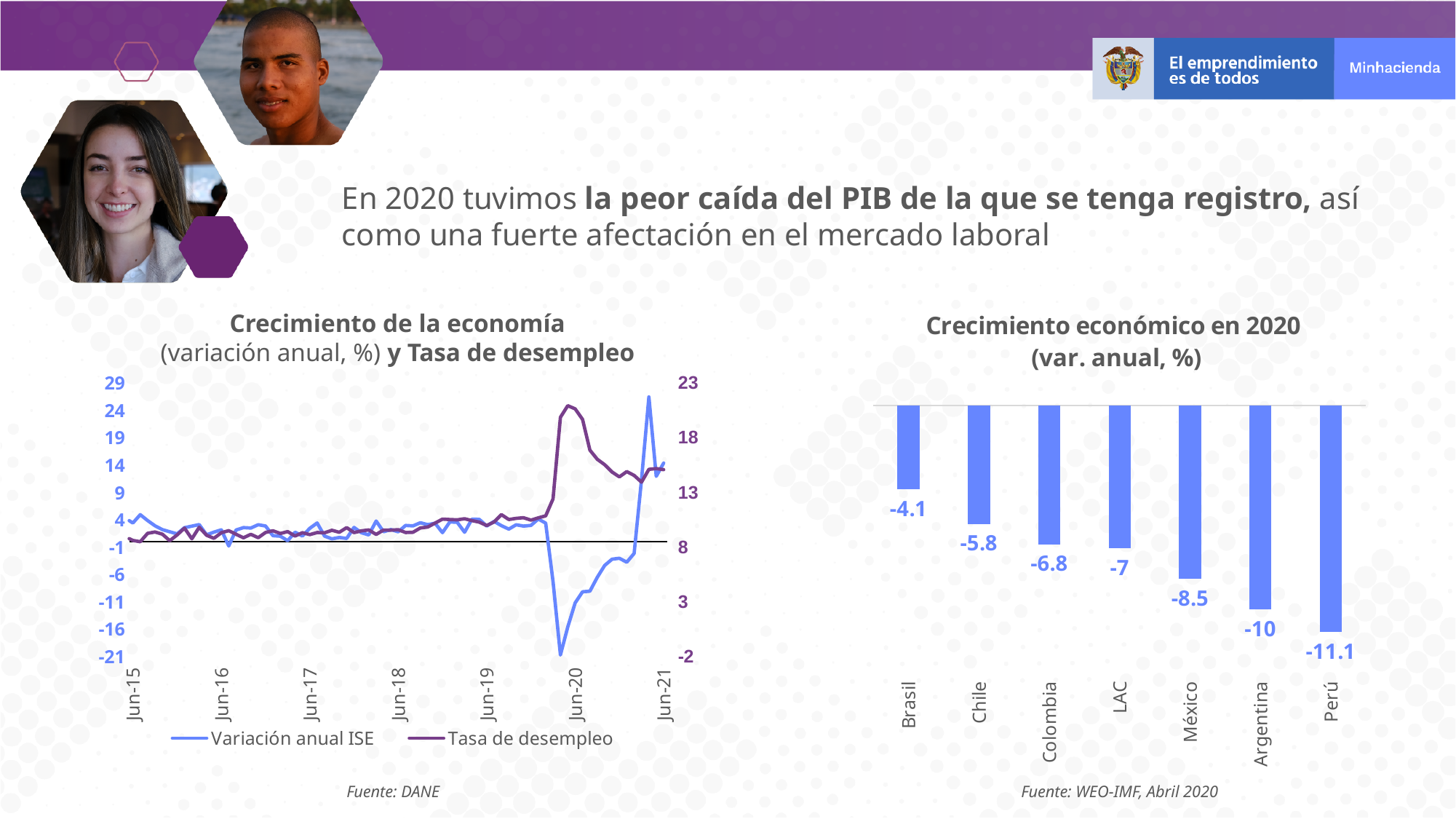
In the chart 'Crecimiento de la economía (variación anual, %) y Tasa de desempleo', which series is drawn in dark purple? Tasa de desempleo In the chart 'Crecimiento económico en 2020 (var. anual, %)', what is the value for LAC? -7 What type of chart is 'Crecimiento de la economía (variación anual, %) y Tasa de desempleo'? Line chart In the chart 'Crecimiento económico en 2020 (var. anual, %)', what is the value for Perú? -11.1 How many countries or regions are shown in the chart 'Crecimiento económico en 2020 (var. anual, %)'? 7 In the chart 'Crecimiento económico en 2020 (var. anual, %)', which country has the lowest value? Perú How many series does the legend of the chart 'Crecimiento de la economía (variación anual, %) y Tasa de desempleo' list? 2 In the chart 'Crecimiento económico en 2020 (var. anual, %)', what is the difference between the values for Argentina and Chile? 4.2 In the chart 'Crecimiento económico en 2020 (var. anual, %)', which has a higher value, México or Colombia? Colombia What type of chart is 'Crecimiento económico en 2020 (var. anual, %)'? Bar chart In the chart 'Crecimiento económico en 2020 (var. anual, %)', which country has the smallest decline (highest value)? Brasil In the chart 'Crecimiento económico en 2020 (var. anual, %)', what is the value for Colombia? -6.8